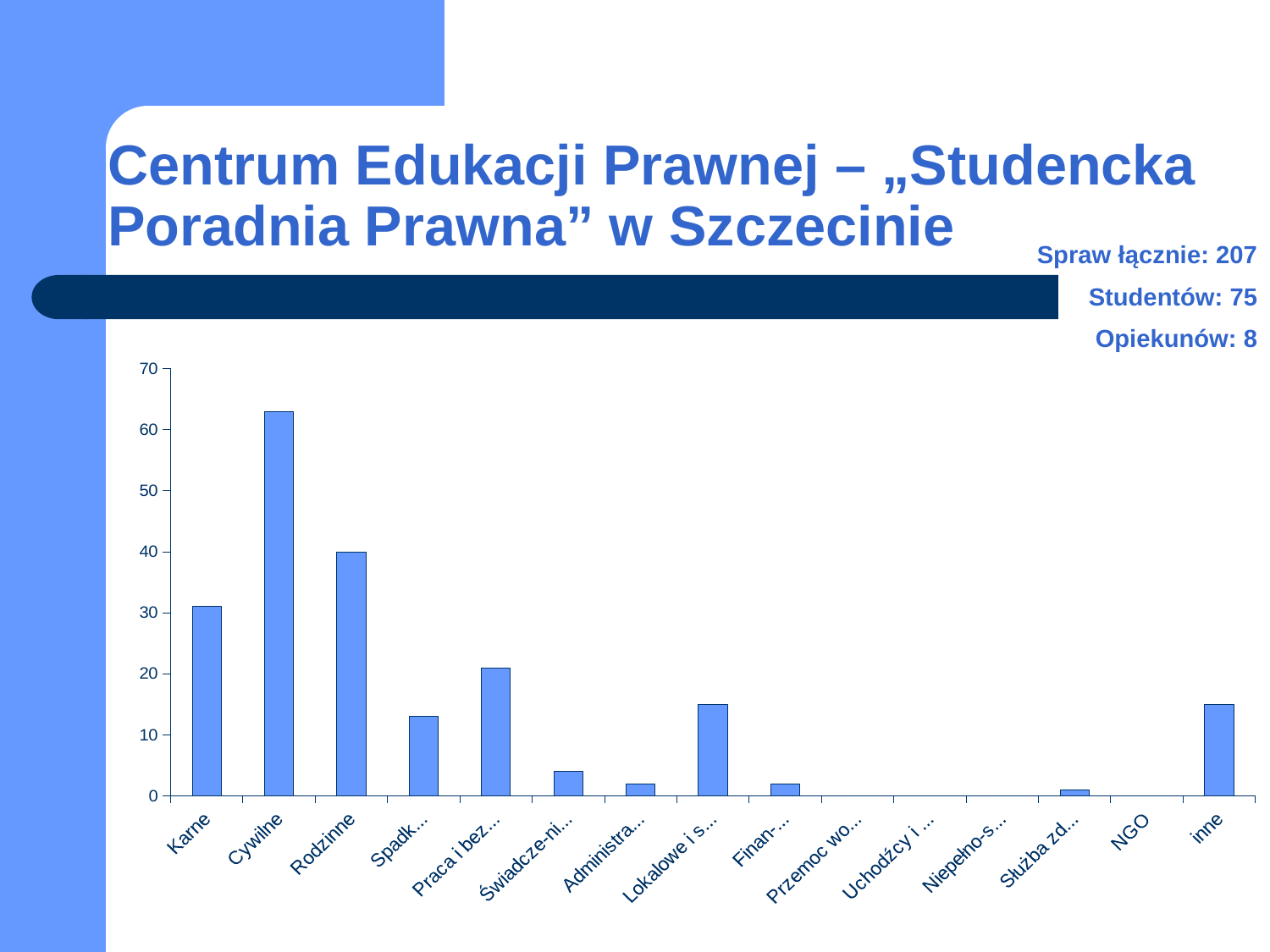
Is the value for Praca i bez... greater or less than 30? less How many categories are shown on the x axis of the chart? 15 Is the value for Cywilne greater or less than 60? greater Is the value for Lokalowe i s... greater or less than 10? greater What kind of chart is shown on the slide? bar chart What is the highest value shown on the y axis of the chart? 70 Which is larger, the value for Cywilne or the value for Rodzinne? Cywilne Which is larger, the value for Karne or the value for Rodzinne? Rodzinne Which category has the highest bar in the chart? Cywilne